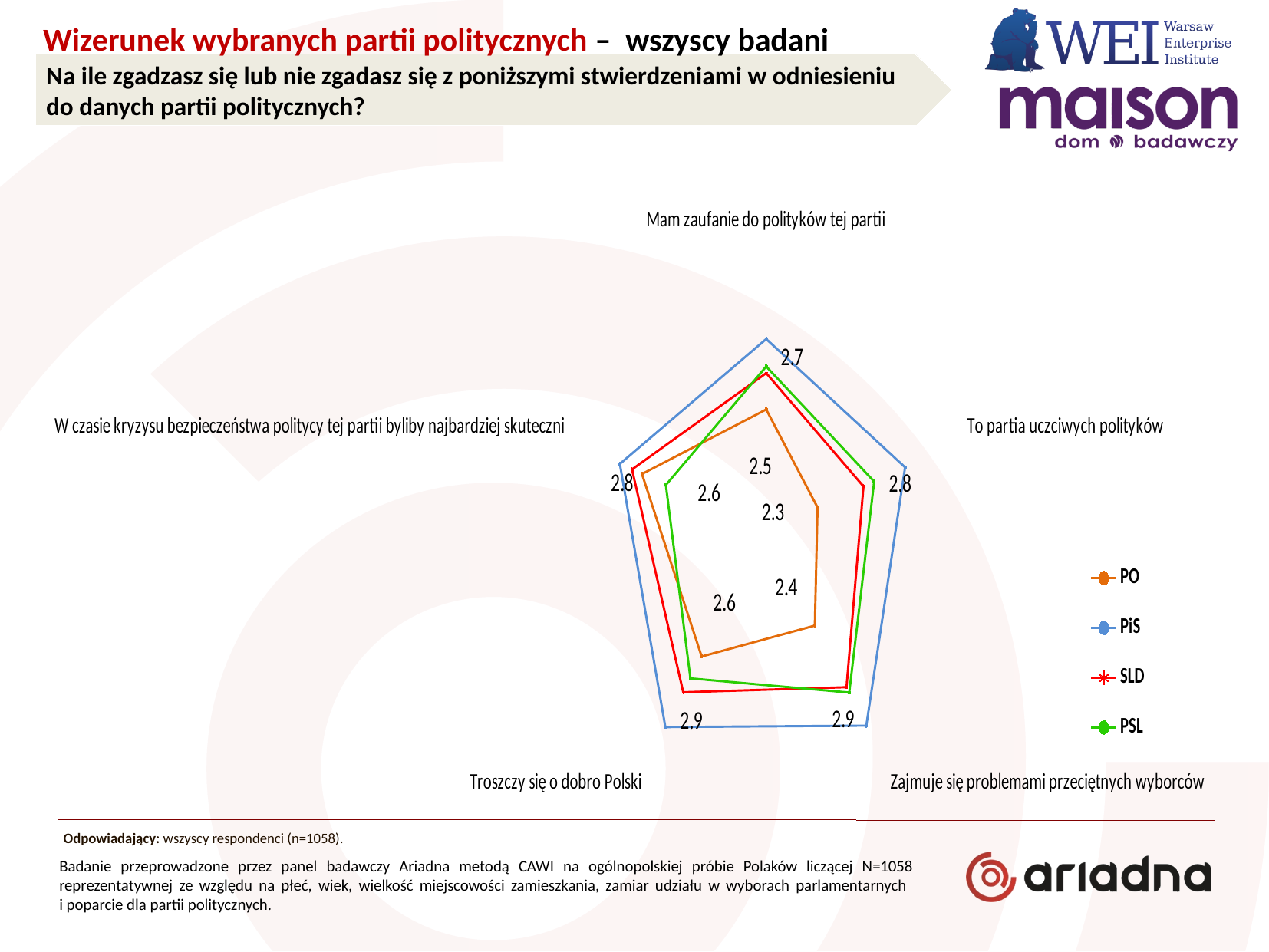
Which is larger on "Zajmuje się problemami przeciętnych wyborców": the value for PiS or for PO? PiS Which parties are listed in the legend? PO, PiS, SLD, PSL What is the difference between the PiS and PO values on "Mam zaufanie do polityków tej partii"? 0.2 What is the value for PO on "Zajmuje się problemami przeciętnych wyborców"? 2.4 How many statements (axes) are plotted on the radar chart? 5 What is the value for PiS on "Troszczy się o dobro Polski"? 2.9 What is the value for PiS on "Mam zaufanie do polityków tej partii"? 2.7 How many series does the legend list? 4 What is the value for PO on "To partia uczciwych polityków"? 2.3 What kind of chart is shown on the slide? Radar chart What is the value for PiS on "W czasie kryzysu bezpieczeństwa politycy tej partii byliby najbardziej skuteczni"? 2.8 Which party has the lowest value on "To partia uczciwych polityków"? PO